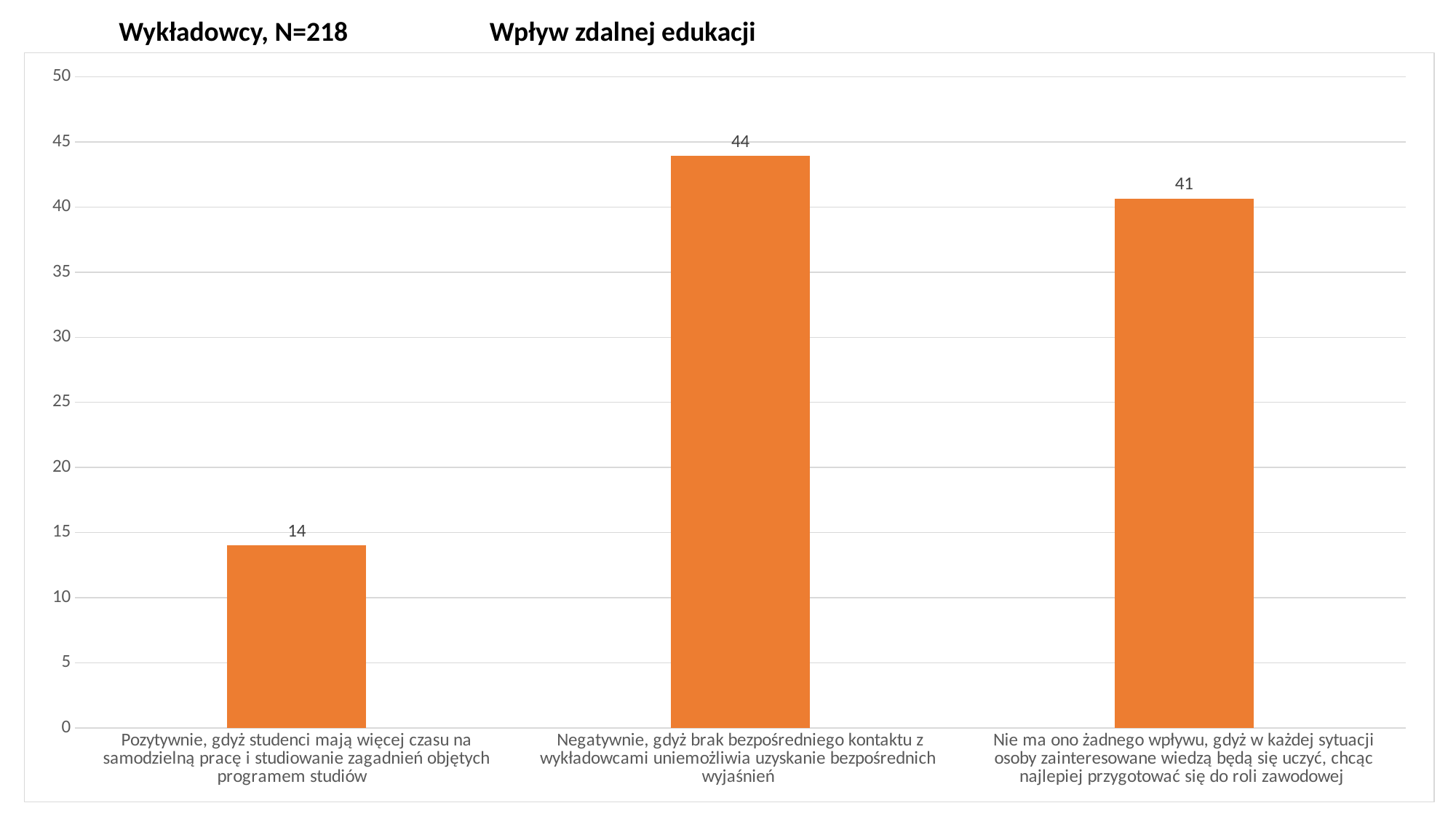
What is the difference between the value for 'Negatywnie...' and the value for 'Nie ma ono żadnego wpływu...'? 3 Which category has the lowest value? Pozytywnie, gdyż studenci mają więcej czasu na samodzielną pracę i studiowanie zagadnień objętych programem studiów What is the title of the chart? Wpływ zdalnej edukacji How many categories are shown in the chart? 3 What is the difference between the value for 'Negatywnie...' and the value for 'Pozytywnie...'? 30 What is the value for the category 'Nie ma ono żadnego wpływu, gdyż w każdej sytuacji osoby zainteresowane wiedzą będą się uczyć, chcąc najlepiej przygotować się do roli zawodowej'? 41 What is the value for the category 'Pozytywnie, gdyż studenci mają więcej czasu na samodzielną pracę i studiowanie zagadnień objętych programem studiów'? 14 Is the value for 'Nie ma ono żadnego wpływu...' greater or less than 35? greater Which category has the highest value? Negatywnie, gdyż brak bezpośredniego kontaktu z wykładowcami uniemożliwia uzyskanie bezpośrednich wyjaśnień Which is larger: the value for 'Pozytywnie...' or the value for 'Nie ma ono żadnego wpływu...'? Nie ma ono żadnego wpływu... What is the value for the category 'Negatywnie, gdyż brak bezpośredniego kontaktu z wykładowcami uniemożliwia uzyskanie bezpośrednich wyjaśnień'? 44 What kind of chart is shown on the slide? bar chart